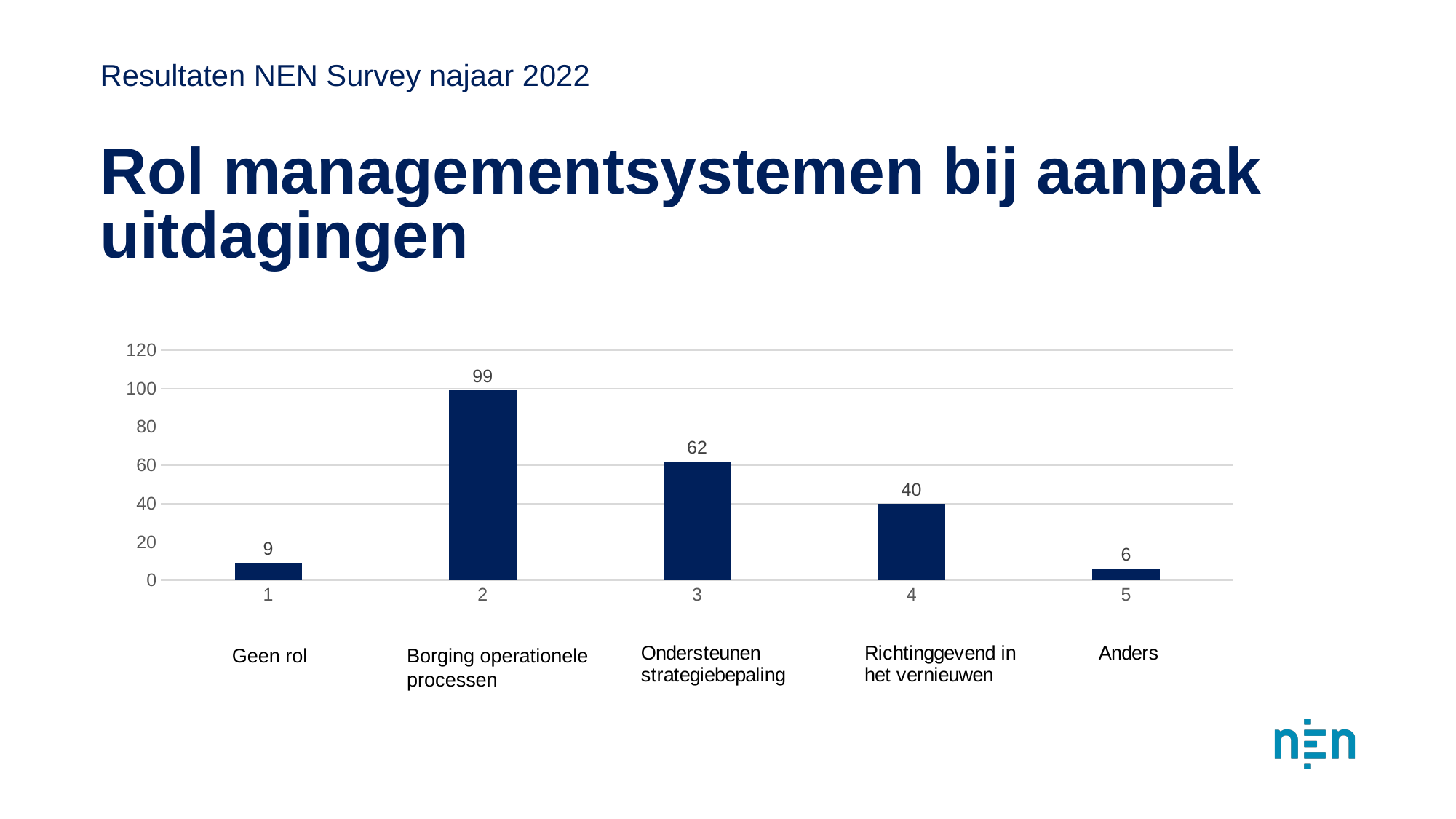
What is the title of the slide containing the chart? Rol managementsystemen bij aanpak uitdagingen What kind of chart is shown on the slide? Bar chart What is the difference between the values for 'Borging operationele processen' and 'Ondersteunen strategiebepaling'? 37 Which category has the lowest value? Anders What is the value for 'Borging operationele processen' (category 2)? 99 What is the value for 'Anders' (category 5)? 6 Which category has the highest value? Borging operationele processen What is the value for 'Ondersteunen strategiebepaling' (category 3)? 62 How many categories are shown in the chart? 5 What is the value for 'Geen rol' (category 1)? 9 What is the value for 'Richtinggevend in het vernieuwen' (category 4)? 40 Which is larger: the value for 'Geen rol' or the value for 'Anders'? Geen rol